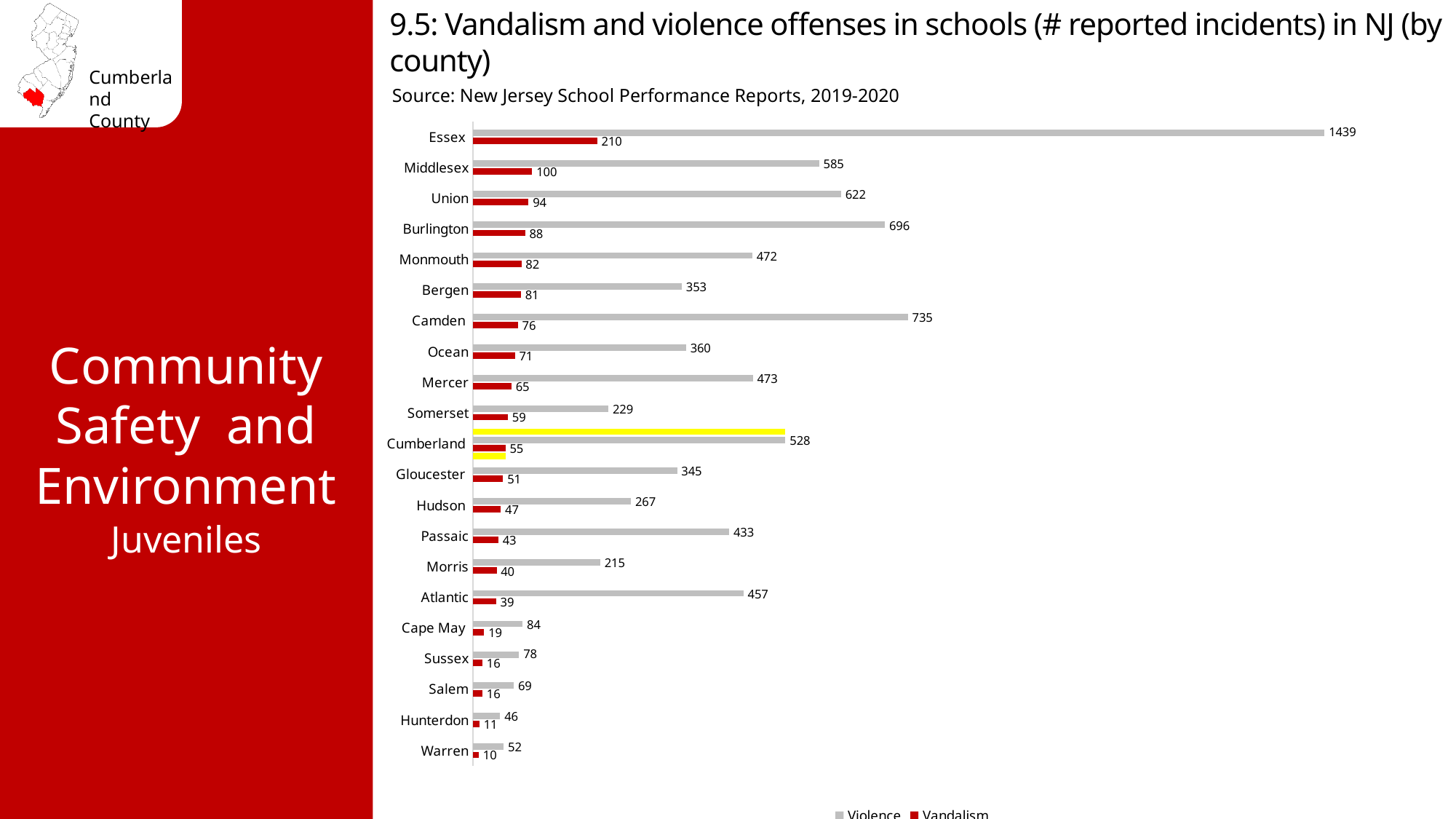
Which county has more reported vandalism incidents, Middlesex or Union? Middlesex Which county has more reported violence incidents, Camden or Burlington? Camden What is the number of reported vandalism incidents in schools for Cumberland County? 55 What is the difference between the violence incidents in Essex and Middlesex? 854 What is the number of reported violence incidents in schools for Camden County? 735 Which series is shown in red in the chart? Vandalism How many series does the legend list? 2 Which county has the lowest number of reported vandalism incidents? Warren Which county has the highest number of reported violence incidents? Essex What is the number of reported violence incidents in schools for Essex County? 1439 What kind of chart is shown on the slide? Bar chart How many counties are shown in the chart? 21